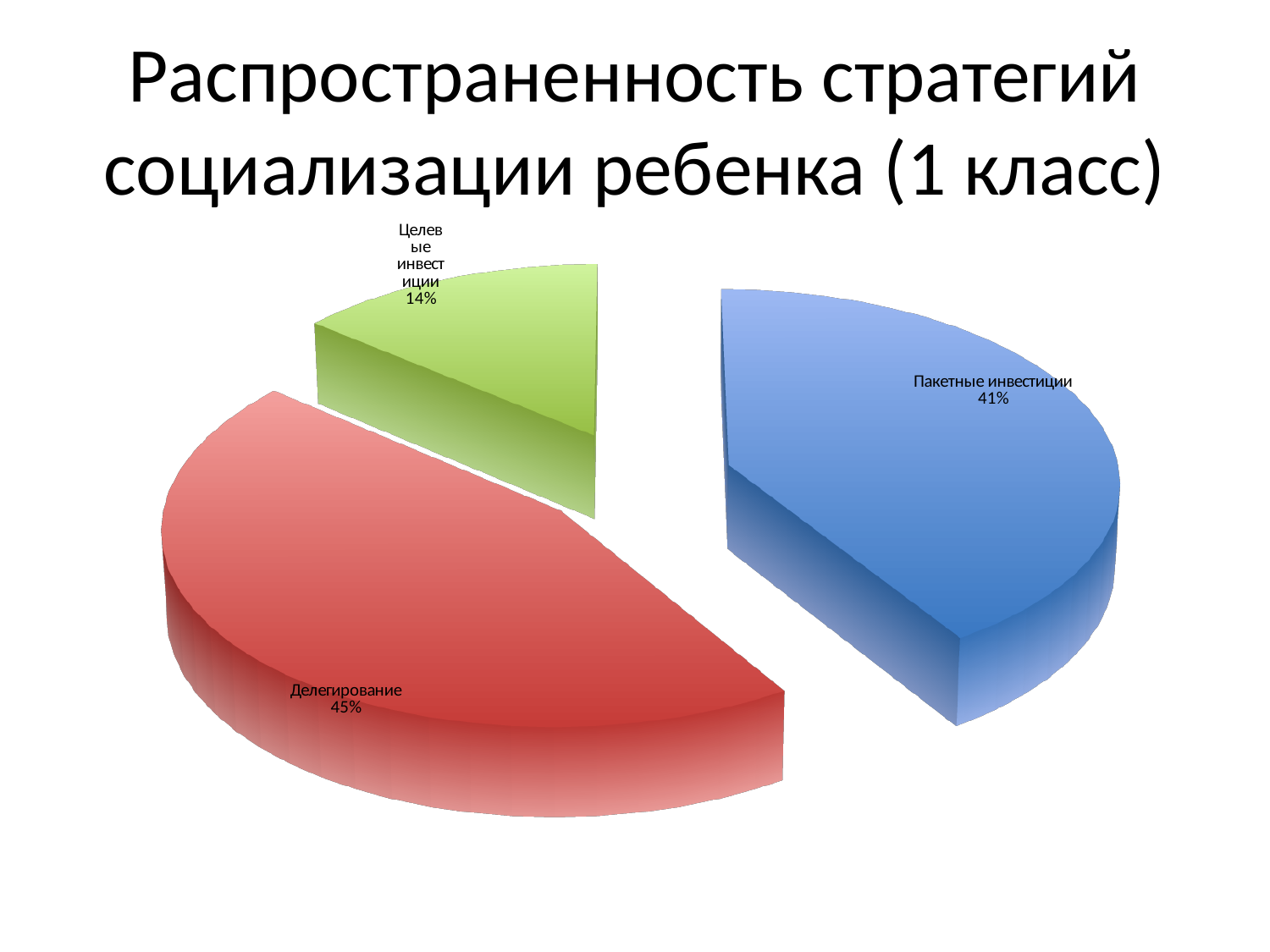
How many slices does the pie chart have? 3 Which is larger, Пакетные инвестиции or Целевые инвестиции? Пакетные инвестиции What colour is the Делегирование slice? red What is the difference between the shares of Делегирование and Пакетные инвестиции? 4% What share does Делегирование have? 45% Which slice is the smallest? Целевые инвестиции What share does Пакетные инвестиции have? 41% What is the difference between the shares of Пакетные инвестиции and Целевые инвестиции? 27% Which slice is the largest? Делегирование What share does Целевые инвестиции have? 14% What kind of chart is shown on the slide? pie chart What is the title of the slide? Распространенность стратегий социализации ребенка (1 класс)